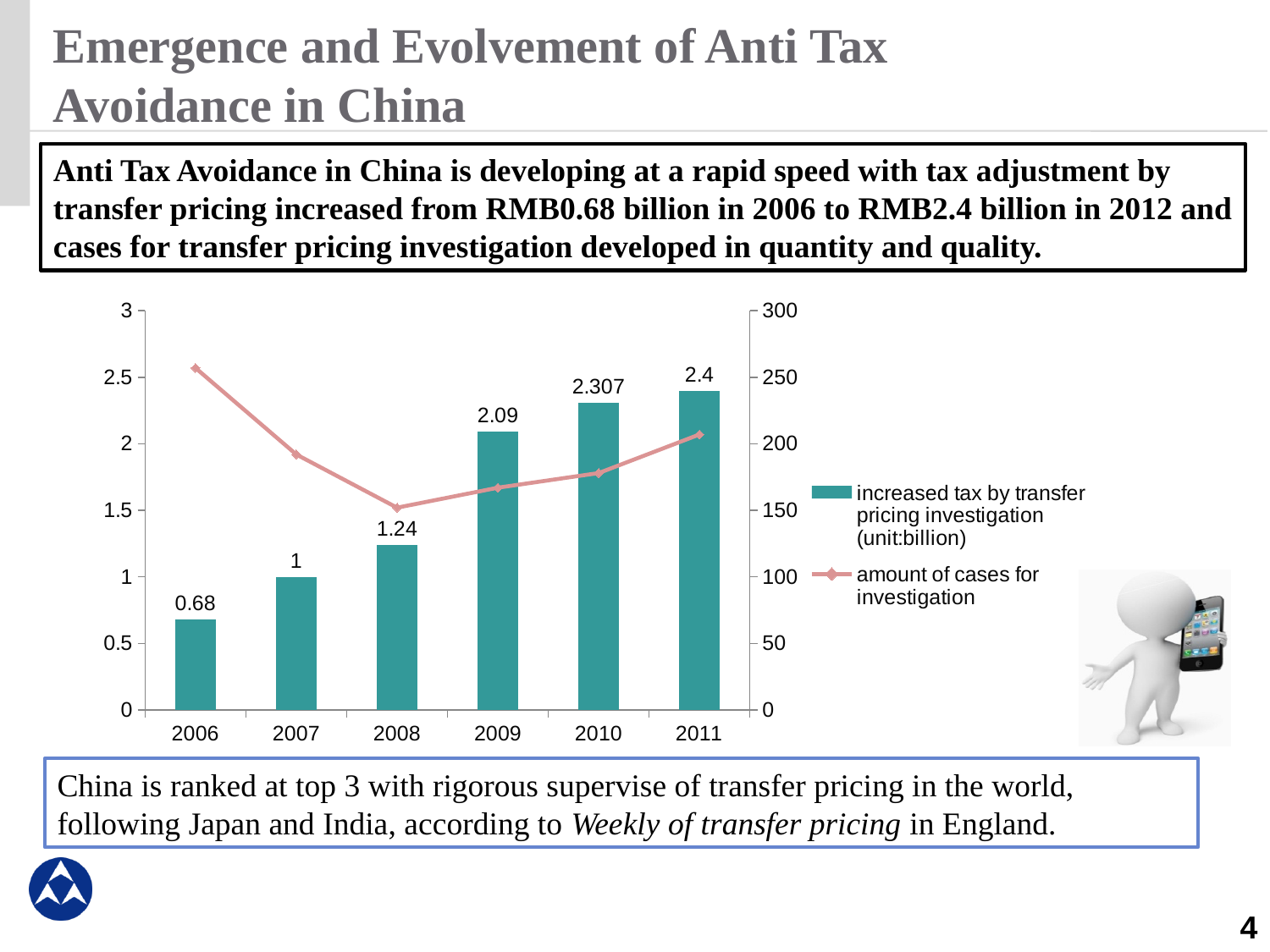
What is the difference in increased tax by transfer pricing investigation between 2011 and 2006? 1.72 What is the value of increased tax by transfer pricing investigation for 2008? 1.24 Is the amount of cases for investigation in 2006 greater or less than 200? greater Which year has the lowest increased tax by transfer pricing investigation? 2006 How many years are shown on the x axis of the chart? 6 How many series does the chart legend list? 2 What is the value of increased tax by transfer pricing investigation for 2010? 2.307 Do the bars for increased tax by transfer pricing investigation rise or fall from 2006 to 2011? rise Which year has a larger increased tax by transfer pricing investigation, 2009 or 2007? 2009 Which year has the highest increased tax by transfer pricing investigation? 2011 What is the value of increased tax by transfer pricing investigation for 2006? 0.68 Is the amount of cases for investigation in 2008 greater or less than 200? less